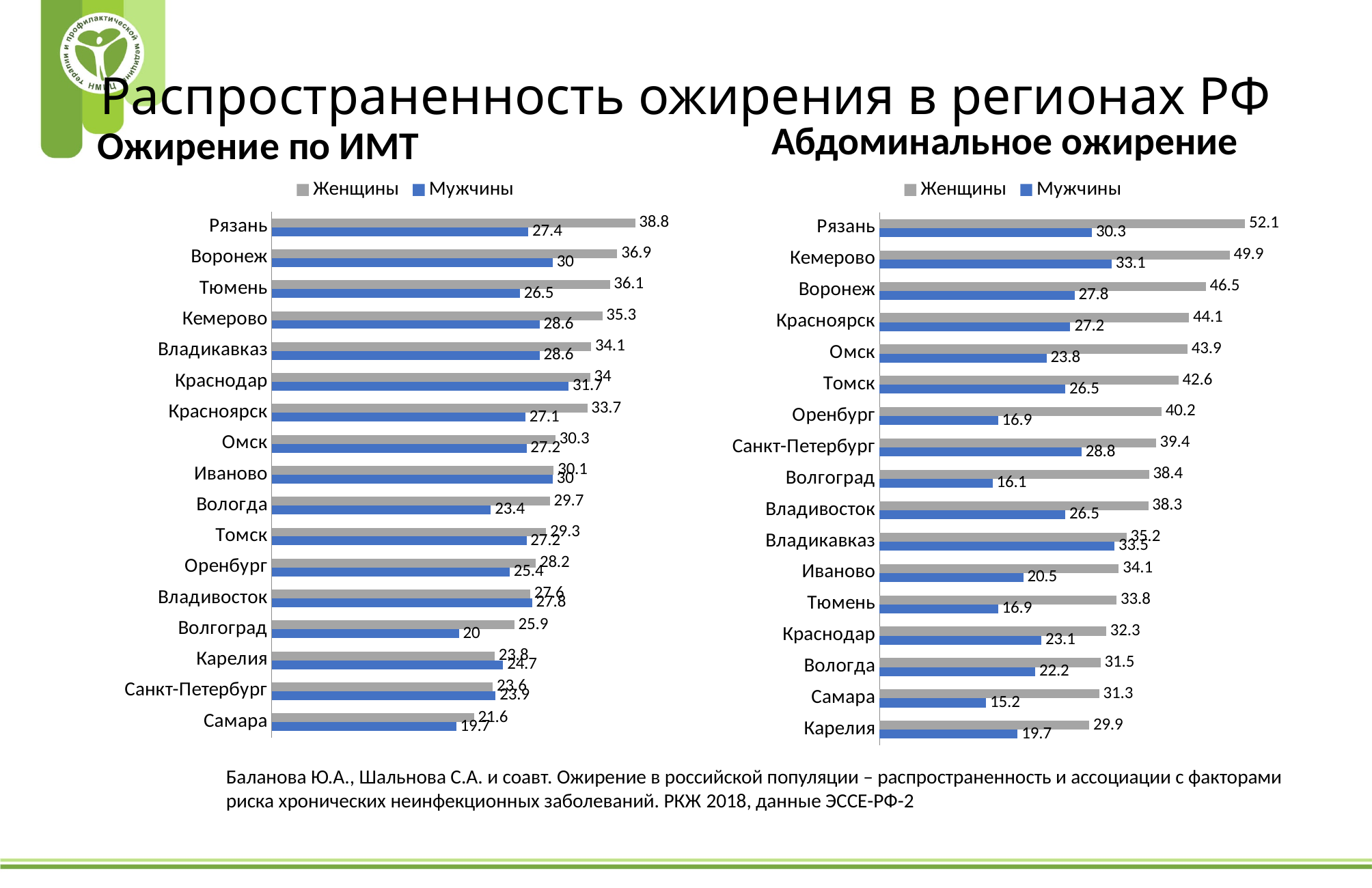
In the 'Ожирение по ИМТ' chart, what is the value for Мужчины in Вологда? 23.4 In the 'Ожирение по ИМТ' chart, which region has the lowest value for Женщины? Самара How many series does the legend of the 'Ожирение по ИМТ' chart list? 2 In the 'Абдоминальное ожирение' chart, what is the difference between the Женщины values for Рязань and Кемерово? 2.2 How many regions are shown in the 'Абдоминальное ожирение' chart? 17 In the 'Ожирение по ИМТ' chart, which is larger for Краснодар: the Женщины value or the Мужчины value? Женщины What type of chart is the 'Абдоминальное ожирение' chart? Bar chart In the 'Ожирение по ИМТ' chart, what is the value for Женщины in Рязань? 38.8 In the 'Абдоминальное ожирение' chart, which region has the lowest value for Мужчины? Самара In the 'Ожирение по ИМТ' chart, what is the difference between the Женщины and Мужчины values for Волгоград? 5.9 In the 'Абдоминальное ожирение' chart, which region has the highest value for Женщины? Рязань In the 'Абдоминальное ожирение' chart, what is the value for Мужчины in Оренбург? 16.9